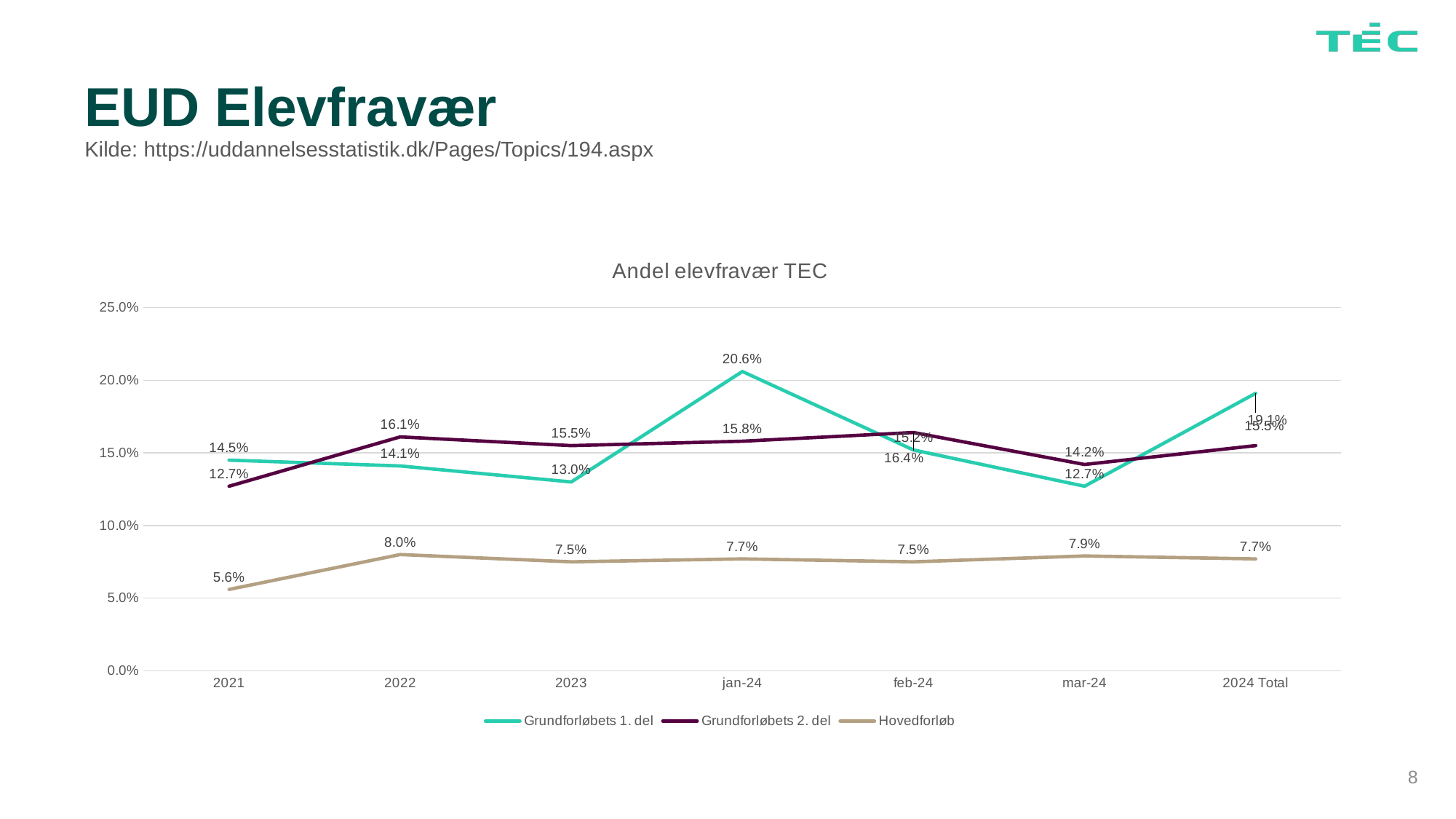
In which period is Hovedforløb lowest? 2021 What is the value for Hovedforløb in 2021? 5.6% In 2023, which is larger: Grundforløbets 1. del or Grundforløbets 2. del? Grundforløbets 2. del What is the title of the chart? Andel elevfravær TEC What is the value for Grundforløbets 1. del in jan-24? 20.6% Is the value for Hovedforløb in 2022 greater or less than 10.0%? less How many series does the legend list? 3 What is the difference between Grundforløbets 2. del in 2022 and in 2021? 3.4 percentage points What kind of chart is shown on the slide? Line chart What is the value for Grundforløbets 2. del in mar-24? 14.2% In which period is Grundforløbets 1. del highest? jan-24 How many categories are shown on the x axis? 7